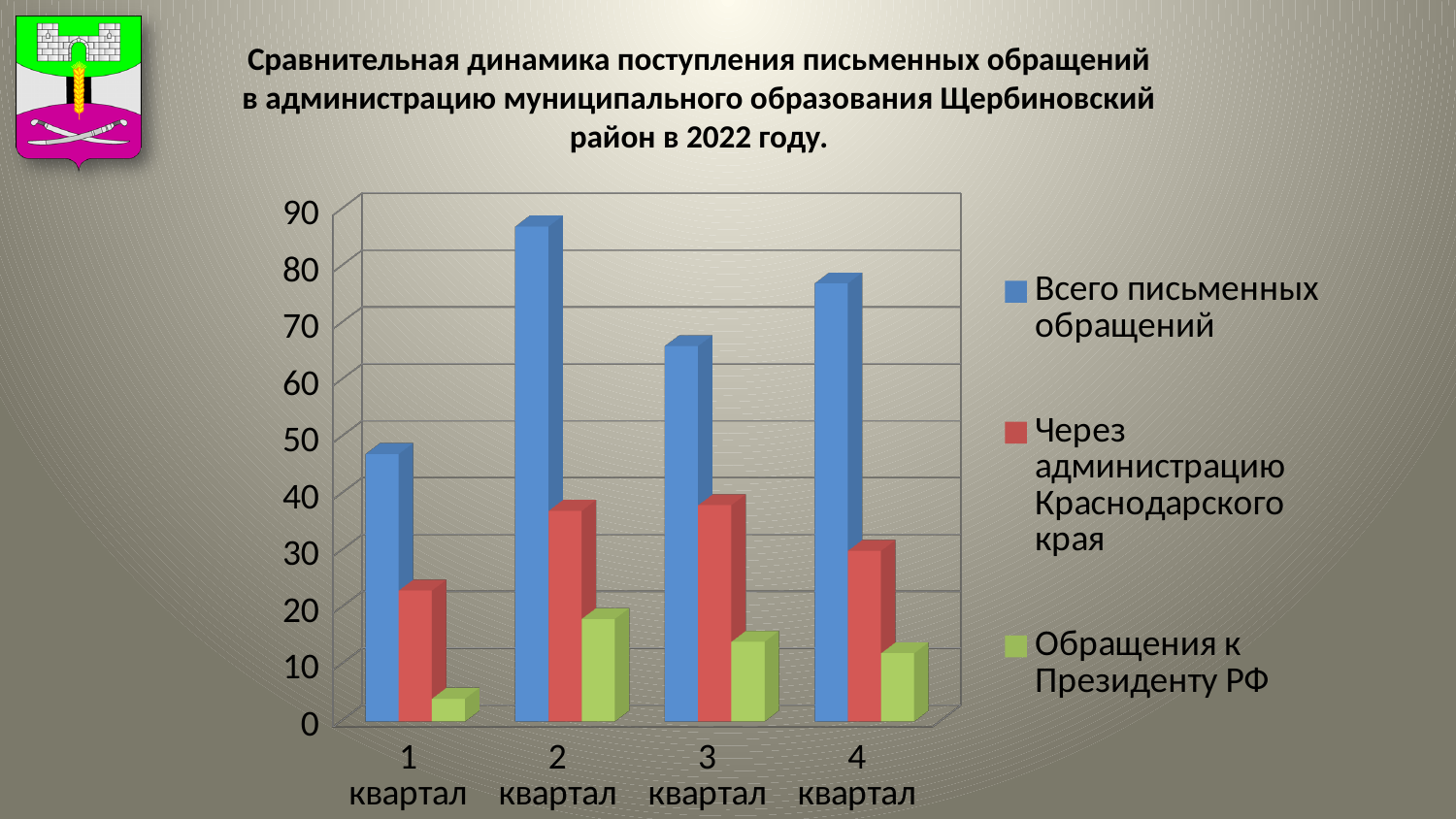
In which quarter is the value for "Всего письменных обращений" highest? 2 квартал How many quarters (categories) are shown on the x axis? 4 What kind of chart is shown on the slide? bar chart Which is larger for "Всего письменных обращений": 3 квартал or 4 квартал? 4 квартал Is the value for "Обращения к Президенту РФ" in 1 квартал greater or less than 10? less How many series does the legend list? 3 Is the value for "Всего письменных обращений" in 1 квартал greater or less than 50? less Is the value for "Всего письменных обращений" in 2 квартал greater or less than 80? greater Which colour represents "Через администрацию Краснодарского края" in the legend? red In which quarter is the value for "Всего письменных обращений" lowest? 1 квартал Does the value for "Обращения к Президенту РФ" rise or fall from 2 квартал to 4 квартал? fall In which quarter is the value for "Обращения к Президенту РФ" lowest? 1 квартал